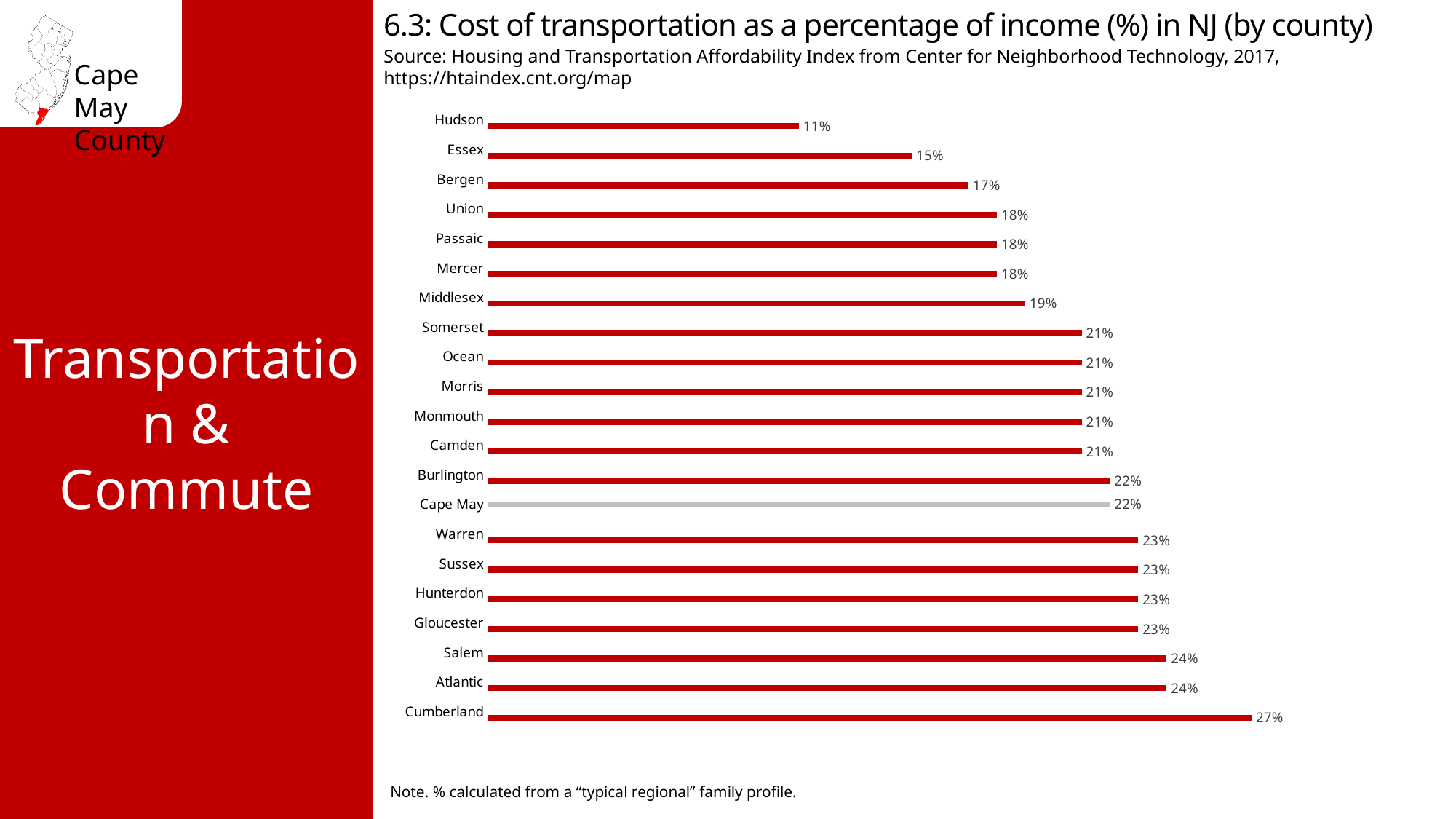
What is the cost of transportation as a percentage of income for Cape May? 22% What is the value shown for Middlesex? 19% Which is larger, the value for Bergen or the value for Salem? Salem Which is larger, the value for Essex or the value for Middlesex? Middlesex Which county has the lowest cost of transportation as a percentage of income? Hudson What is the difference between the values for Cumberland and Hudson? 16% How many counties are shown in the chart? 21 What is the cost of transportation as a percentage of income for Hudson? 11% Which county's bar is shown in grey rather than red? Cape May What is the difference between the values for Cape May and Essex? 7% What kind of chart is shown on the slide? Bar chart Which county has the highest cost of transportation as a percentage of income? Cumberland